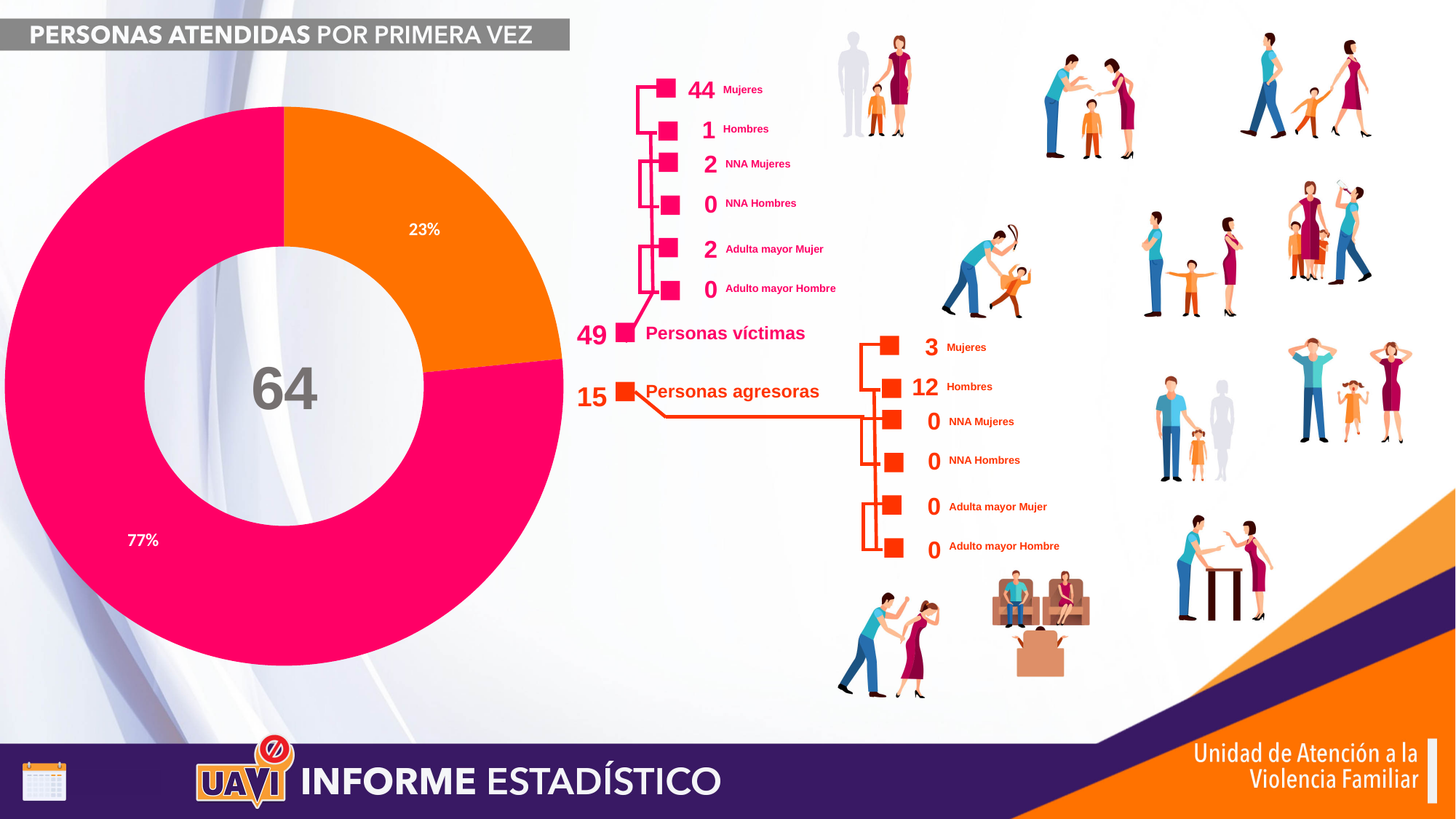
What is the difference in percentage points between the 77% slice and the 23% slice? 54 What kind of chart is shown on the slide? Pie chart (donut) Which is larger, the number of Personas víctimas or the number of Personas agresoras? Personas víctimas What share of the donut chart does the pink slice (Personas víctimas) represent? 77% How many Personas víctimas are reported next to the donut chart? 49 How many slices does the donut chart have? 2 Which slice of the donut chart is the smallest? Personas agresoras (23%) What share of the donut chart does the orange slice (Personas agresoras) represent? 23% What total number is shown in the centre of the donut chart? 64 What is the title of the slide's chart? PERSONAS ATENDIDAS POR PRIMERA VEZ Which slice of the donut chart is the largest? Personas víctimas (77%) How many Personas agresoras are reported next to the donut chart? 15